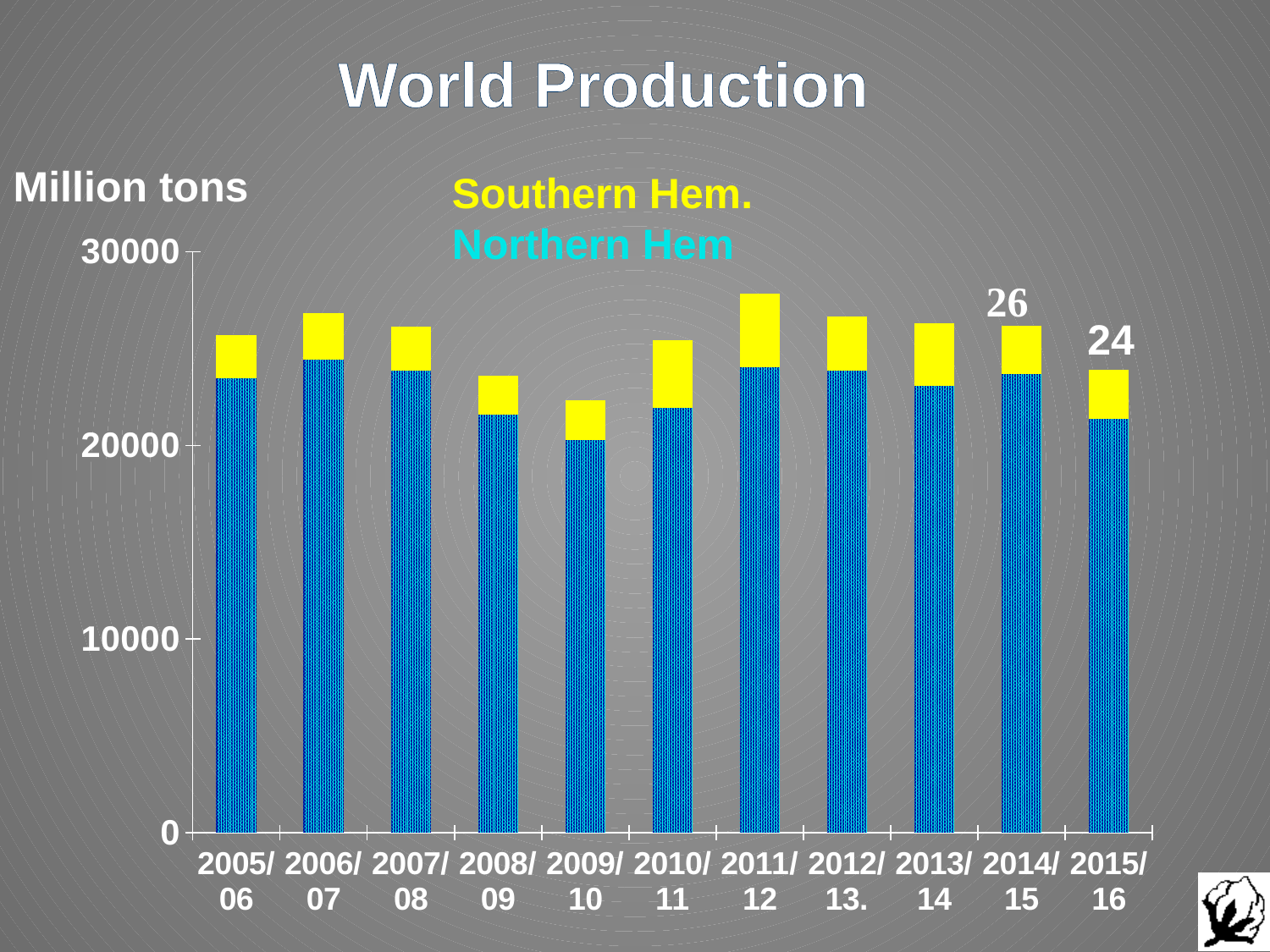
Which season has the highest total bar? 2011/12 What value is labelled above the bar for 2015/16? 24 What kind of chart is shown on the slide? bar chart Is the total bar for 2011/12 greater or less than 30000? less What value is labelled above the bar for 2014/15? 26 Which colour represents Southern Hem. in the chart? yellow Which season has the lowest total bar? 2009/10 What is the difference between the labelled values for 2014/15 and 2015/16? 2 How many seasons (categories) are shown on the x axis? 11 What is the title of the chart? World Production Is the Northern Hem value for 2008/09 greater or less than 20000? greater How many series does the legend list? 2